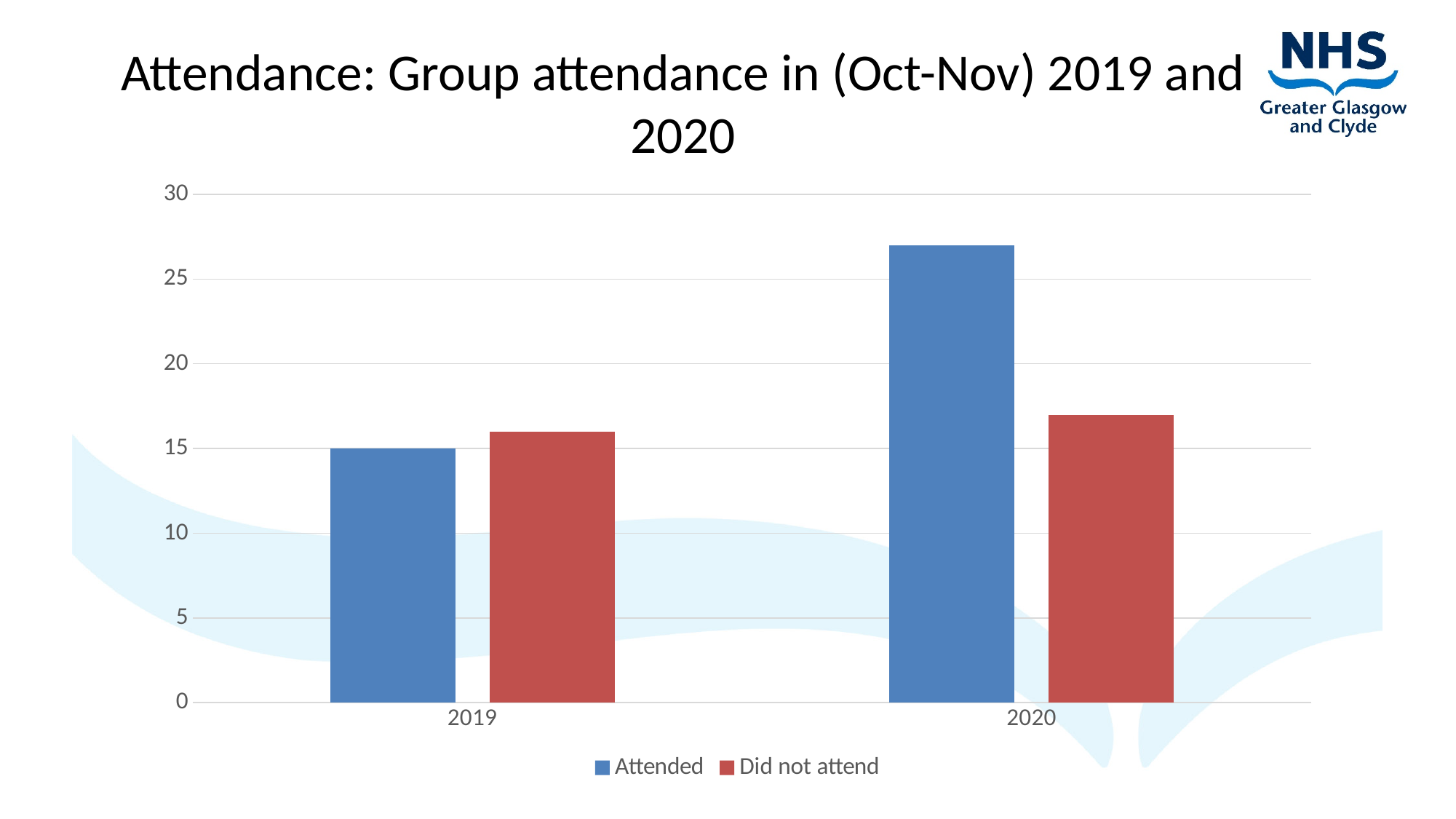
What type of chart is shown on the slide? bar chart Is the value for Attended in 2020 greater or less than 25? greater Which bar is the highest on the chart? Attended in 2020 Which series is shown in red? Did not attend How many year categories are shown on the x axis? 2 What is the title of the chart? Attendance: Group attendance in (Oct-Nov) 2019 and 2020 Does the Attended value rise or fall from 2019 to 2020? rise How many series does the legend list? 2 Is the value for Did not attend in 2019 greater or less than 15? greater Is the value for Did not attend in 2020 greater or less than 20? less What is the value for Attended in 2019? 15 In 2020, which is larger: Attended or Did not attend? Attended